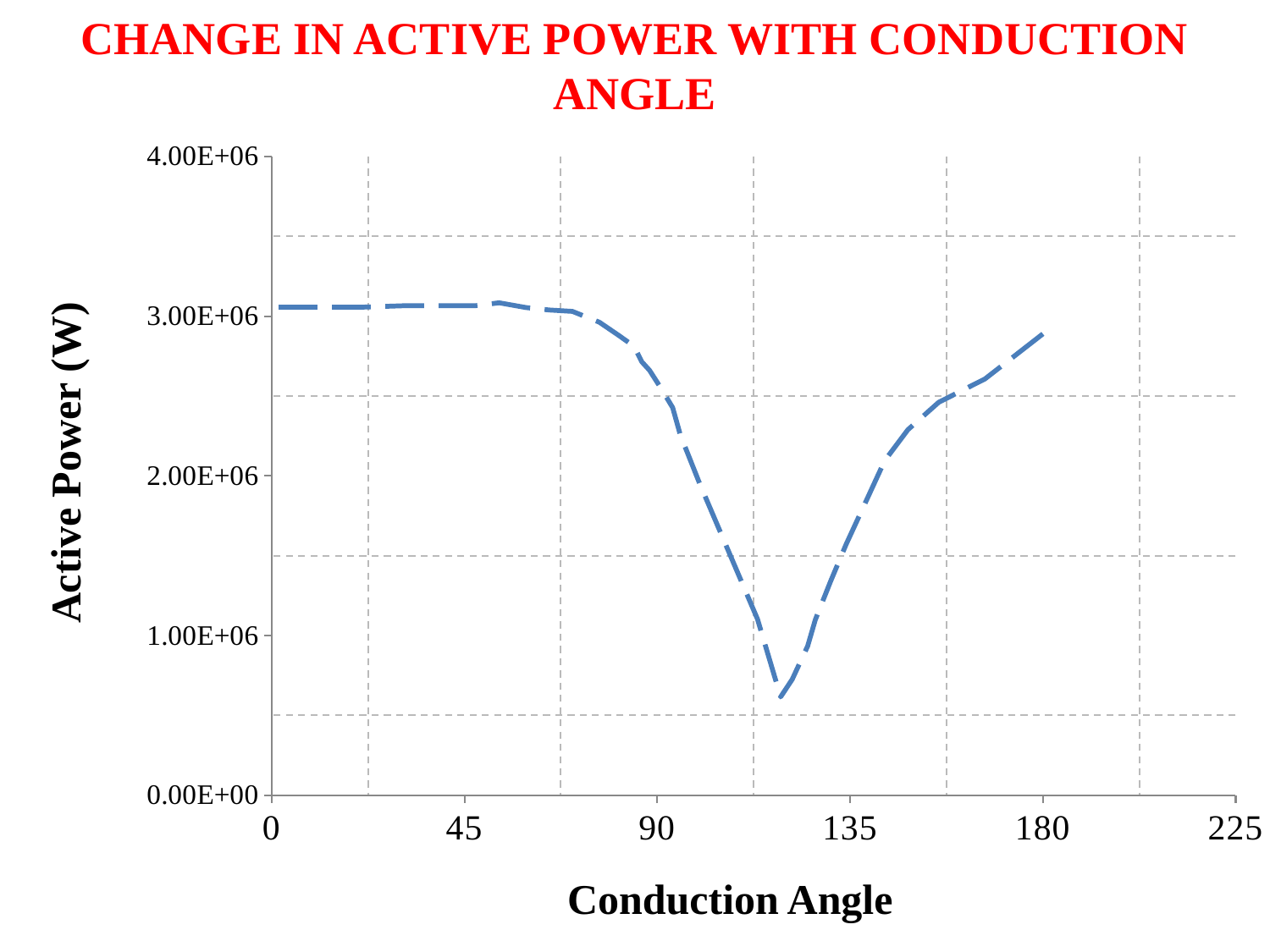
What kind of chart is shown on the slide? line chart Which is larger, the active power at a conduction angle of 0 or at 180? 0 Is the active power at a conduction angle of 180 greater or less than 3.00E+06? less Is the active power at a conduction angle of 0 greater or less than 2.00E+06? greater Does the active power rise or fall as the conduction angle increases from 135 to 180? rise What is the title of the chart? CHANGE IN ACTIVE POWER WITH CONDUCTION ANGLE Is the active power at a conduction angle of 90 greater or less than 2.00E+06? greater What is the label of the y axis? Active Power (W) Does the active power rise or fall as the conduction angle increases from 90 to about 120? fall Which is larger, the active power at a conduction angle of 45 or at 135? 45 Between which two labelled x-axis ticks does the minimum active power occur? 90 and 135